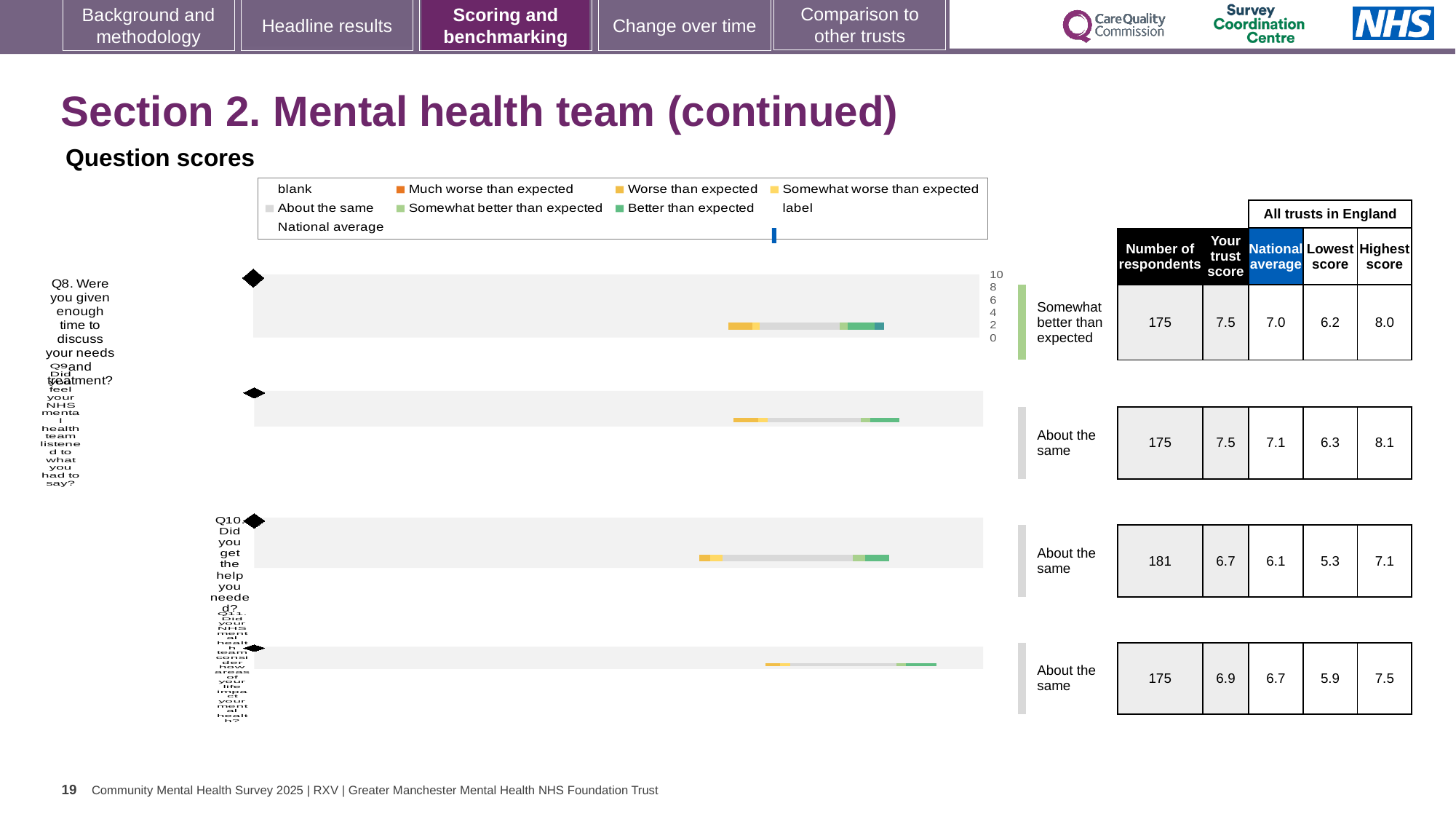
Which question has the highest national average score on this slide? Q9 Is the trust score for Q8 higher or lower than the national average for Q8? higher What is the difference between the trust score and the national average for Q10? 0.6 What is the national average score for Q10 (Did you get the help you needed?)? 6.1 What kind of chart is used to show the question scores on this slide? bar chart How many question charts are shown on this slide? 4 Which question has the lowest 'Your trust score' on this slide? Q10 What is the 'Your trust score' for Q8 (Were you given enough time to discuss your needs and treatment?)? 7.5 What is the highest score among all trusts in England for Q9? 8.1 What benchmark category is shown for Q8 (Were you given enough time to discuss your needs and treatment?)? Somewhat better than expected What is the lowest score among all trusts in England for Q11? 5.9 How many respondents answered Q10 (Did you get the help you needed?)? 181